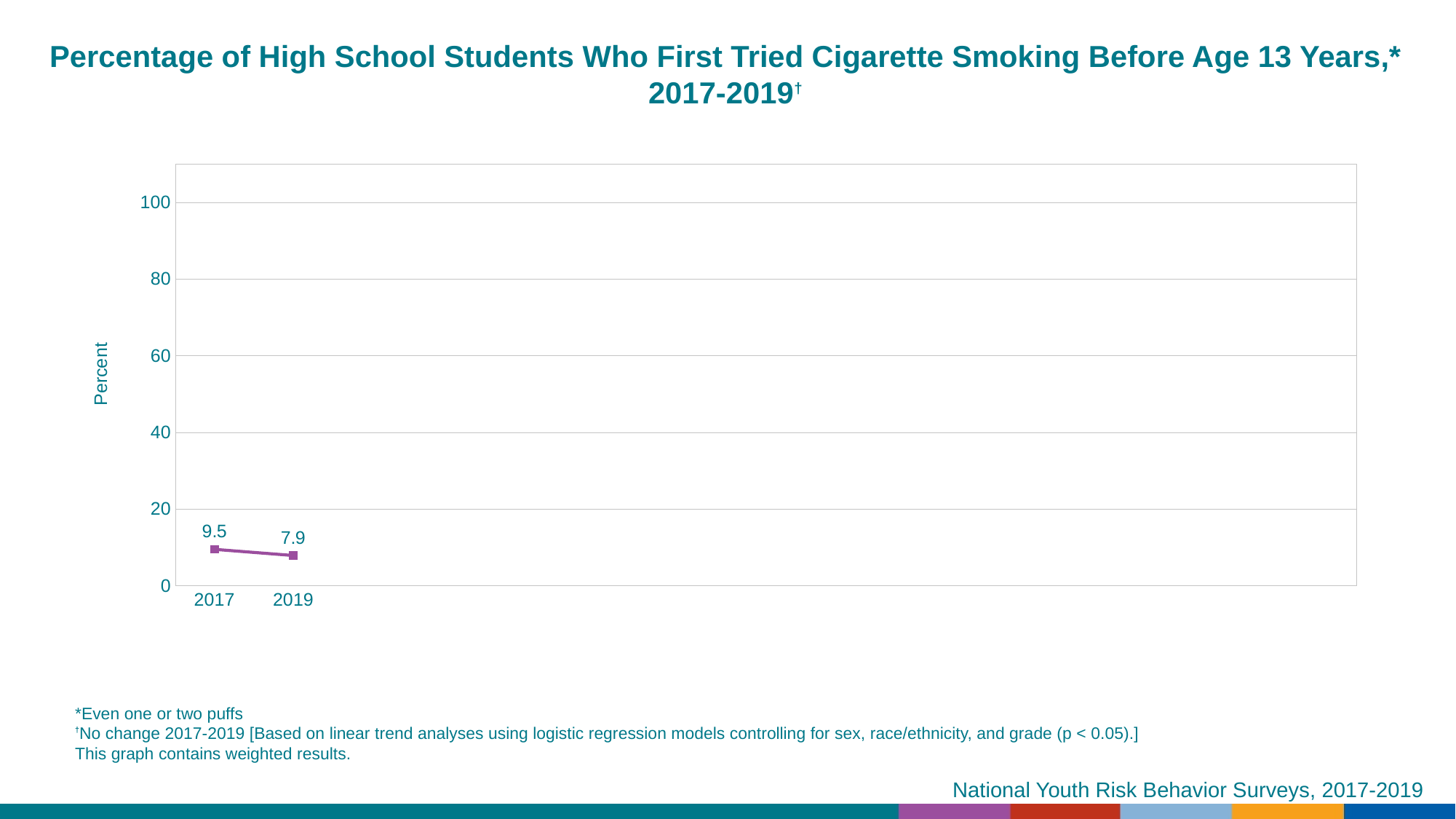
How many data points are plotted on the chart? 2 Which year has the lowest value? 2019 Which year has the highest value? 2017 What is the value for 2017? 9.5 Which is larger, the value for 2017 or the value for 2019? 2017 What is the label on the y axis? Percent What kind of chart is shown on the slide? line chart What is the difference between the values for 2017 and 2019? 1.6 What is the value for 2019? 7.9 Do the values rise or fall from 2017 to 2019? fall What is the title of the chart? Percentage of High School Students Who First Tried Cigarette Smoking Before Age 13 Years, 2017-2019 Is the value for 2017 greater or less than 20? less